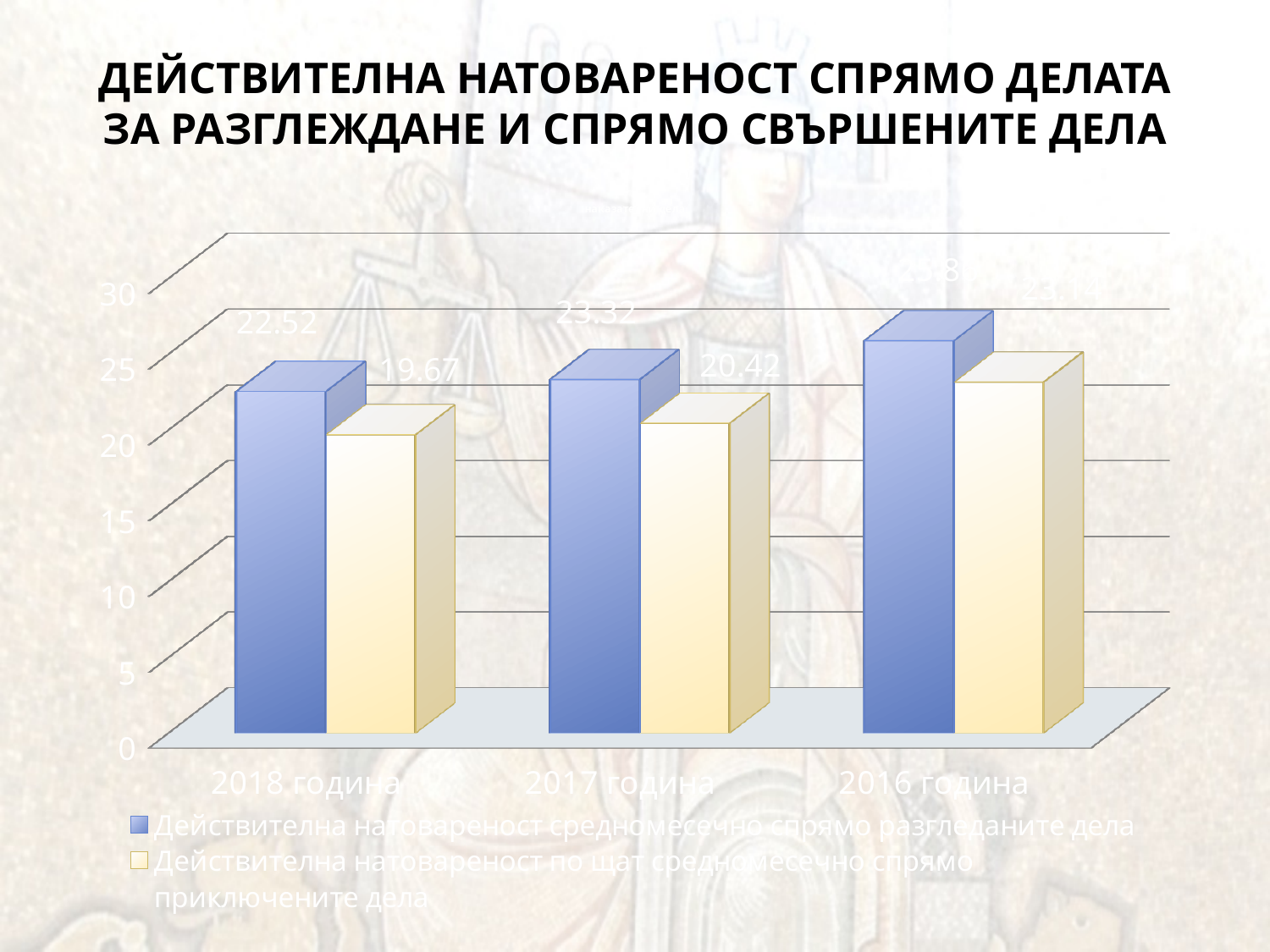
Is the value of 'Действителна натовареност средномесечно спрямо разгледаните дела' for 2016 година greater or less than 25? greater How many series does the chart legend list? 2 How many year categories are shown on the x axis of the chart? 3 What is the value of 'Действителна натовареност средномесечно спрямо разгледаните дела' for 2018 година? 22.52 Which series is shown in blue in the chart? Действителна натовареност средномесечно спрямо разгледаните дела What is the difference between the two series values for 2017 година? 2.90 What is the value of 'Действителна натовареност по щат средномесечно спрямо приключените дела' for 2017 година? 20.42 Which year has the highest value for 'Действителна натовареност средномесечно спрямо разгледаните дела'? 2016 година What type of chart is shown on the slide? bar chart What is the value of 'Действителна натовареност по щат средномесечно спрямо приключените дела' for 2018 година? 19.67 What is the value of 'Действителна натовареност средномесечно спрямо разгледаните дела' for 2017 година? 23.32 What is the difference between the two series values for 2018 година? 2.85